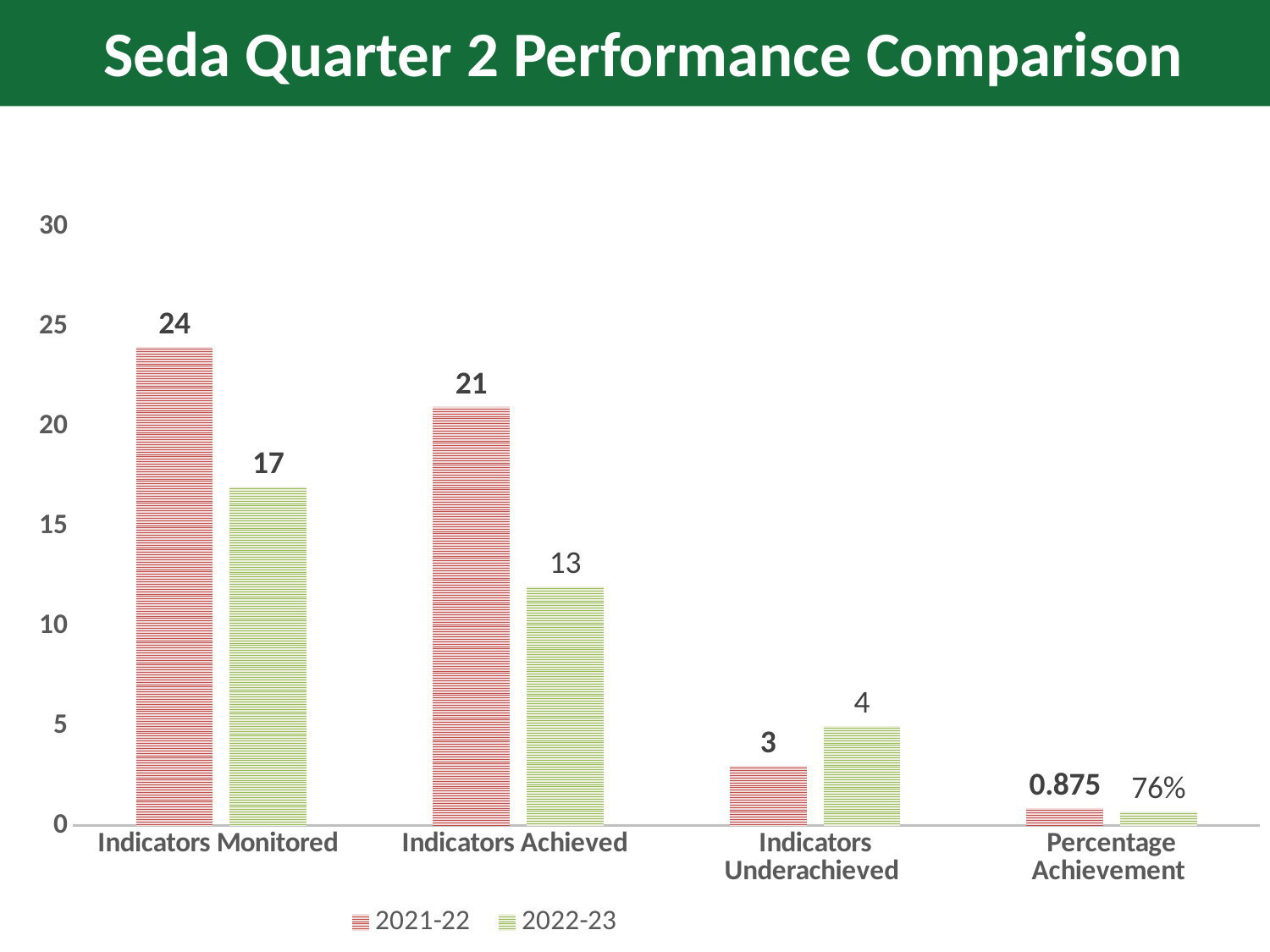
How many series does the legend list? 2 What is the value for Indicators Achieved in the 2022-23 series? 13 How many categories are shown on the x axis? 4 Which series has the larger value for Indicators Underachieved, 2021-22 or 2022-23? 2022-23 Which category has the highest value in the 2021-22 series? Indicators Monitored What is the value for Indicators Underachieved in the 2022-23 series? 4 What is the data label shown for Percentage Achievement in the 2021-22 series? 0.875 What is the difference between the 2021-22 and 2022-23 values for Indicators Achieved? 8 What is the difference between the 2021-22 and 2022-23 values for Indicators Monitored? 7 What kind of chart is shown on the slide? Bar chart What is the data label shown for Percentage Achievement in the 2022-23 series? 76% What is the value for Indicators Monitored in the 2021-22 series? 24